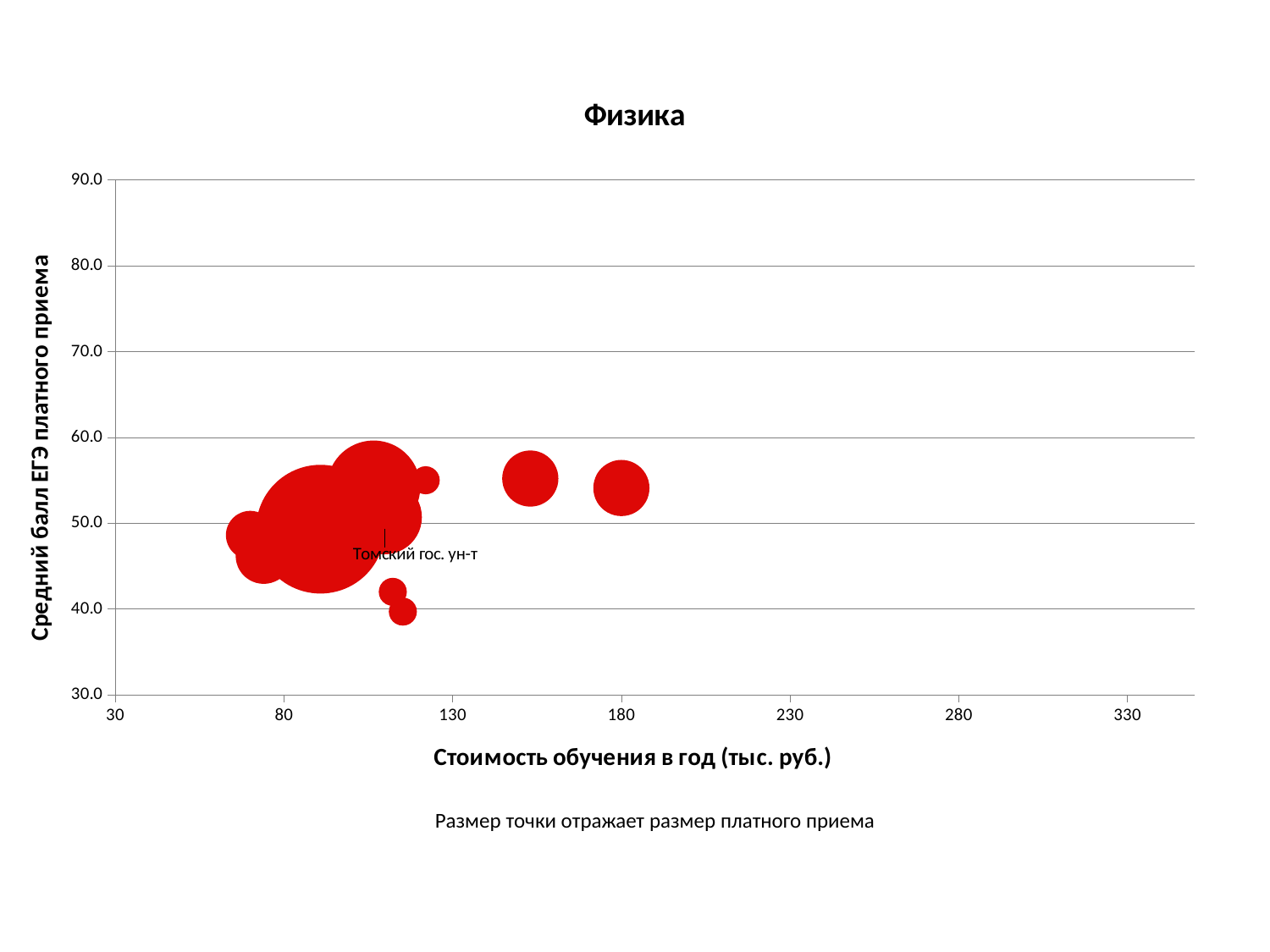
Is the lowest average exam score (y value) of any bubble on the chart greater or less than 30.0? greater Is the highest average exam score (y value) of any bubble on the chart greater or less than 70.0? less What kind of chart is shown on the slide? bubble chart Is the average exam score (y value) for Томский гос. ун-т greater or less than 60.0? less What is the title of the chart? Физика What is the label of the x axis? Стоимость обучения в год (тыс. руб.)